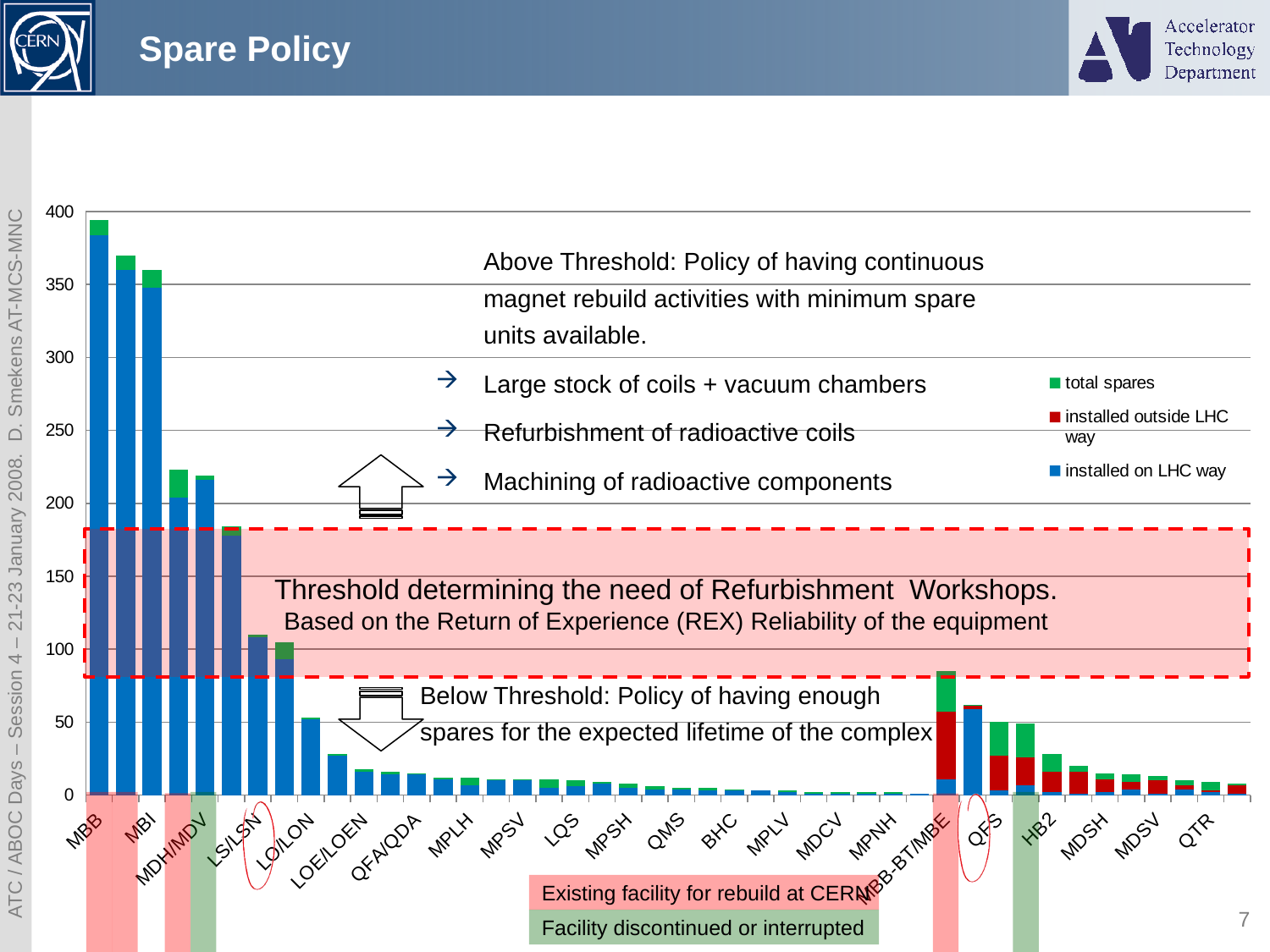
What kind of chart is shown on the slide? stacked bar chart Do the bar heights generally rise or fall from MBB to MPNH along the x axis? fall Is the total bar for MBI greater or less than 350? greater Which category has the highest total bar in the chart? MBB Is the total bar for MBB greater or less than 350? greater Which is larger, the total bar for MBB or for QTR? MBB Which is larger, the total bar for MBB or for MBI? MBB Which colour represents the 'total spares' series in the legend? green Which colour represents the 'installed on LHC way' series in the legend? blue Is the total bar for MBB greater or less than 400? less How many series does the chart legend list? 3